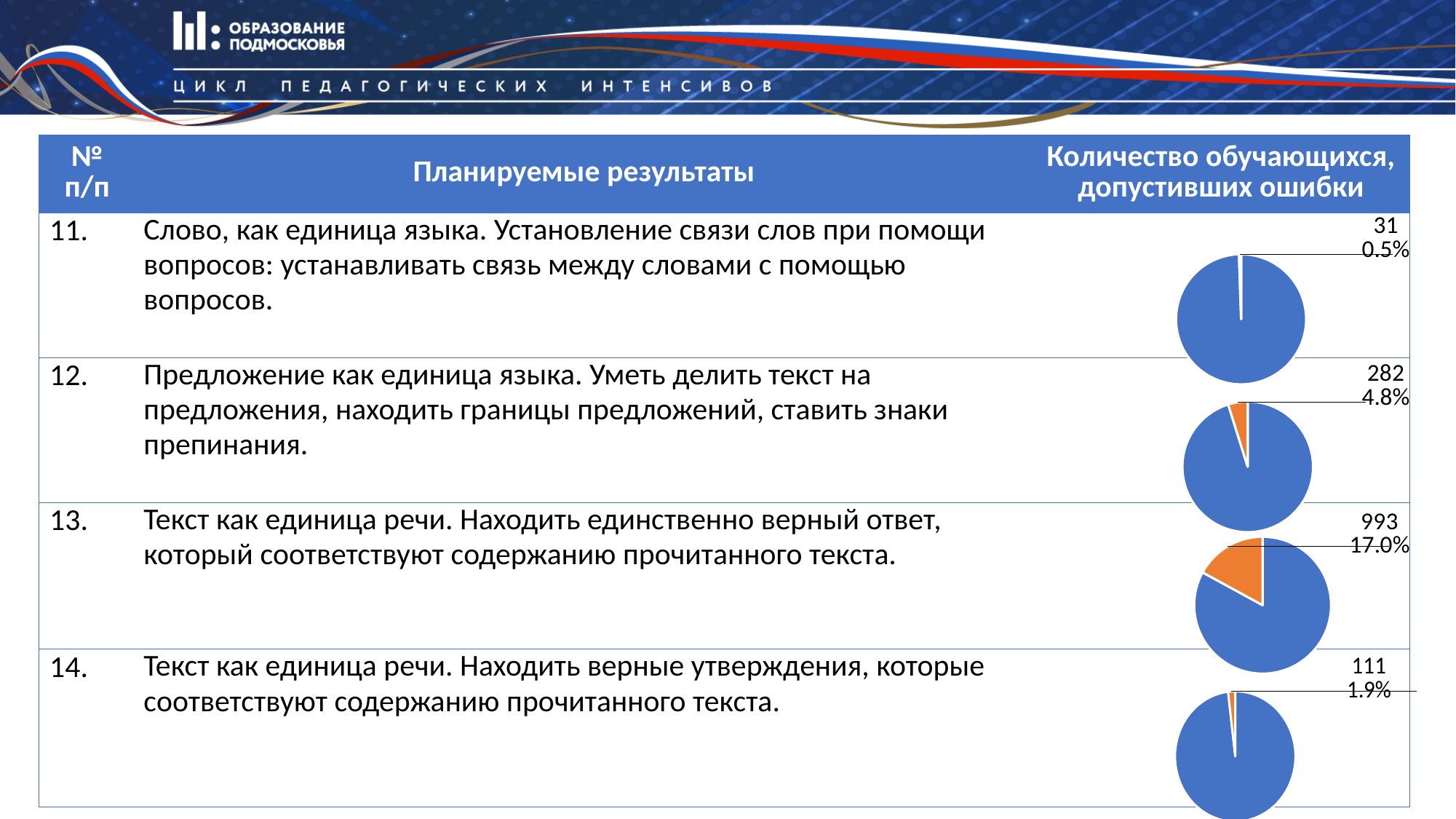
Which row's pie chart shows the smallest number of students who made errors? 11 In the pie chart for row 11, what percentage is labelled on the orange slice? 0.5% In the pie chart for row 11, what number of students who made errors is labelled? 31 In the pie chart for row 14, what number of students who made errors is labelled? 111 In the pie chart for row 14, what percentage is labelled on the orange slice? 1.9% In the pie chart for row 12, what number of students who made errors is labelled? 282 In the pie chart for row 13, what percentage is labelled on the orange slice? 17.0% What kind of charts are shown in the right-hand column of the table? pie charts How many pie charts are on the slide? 4 In the pie chart for row 13, what number of students who made errors is labelled? 993 Which row's pie chart shows the largest number of students who made errors? 13